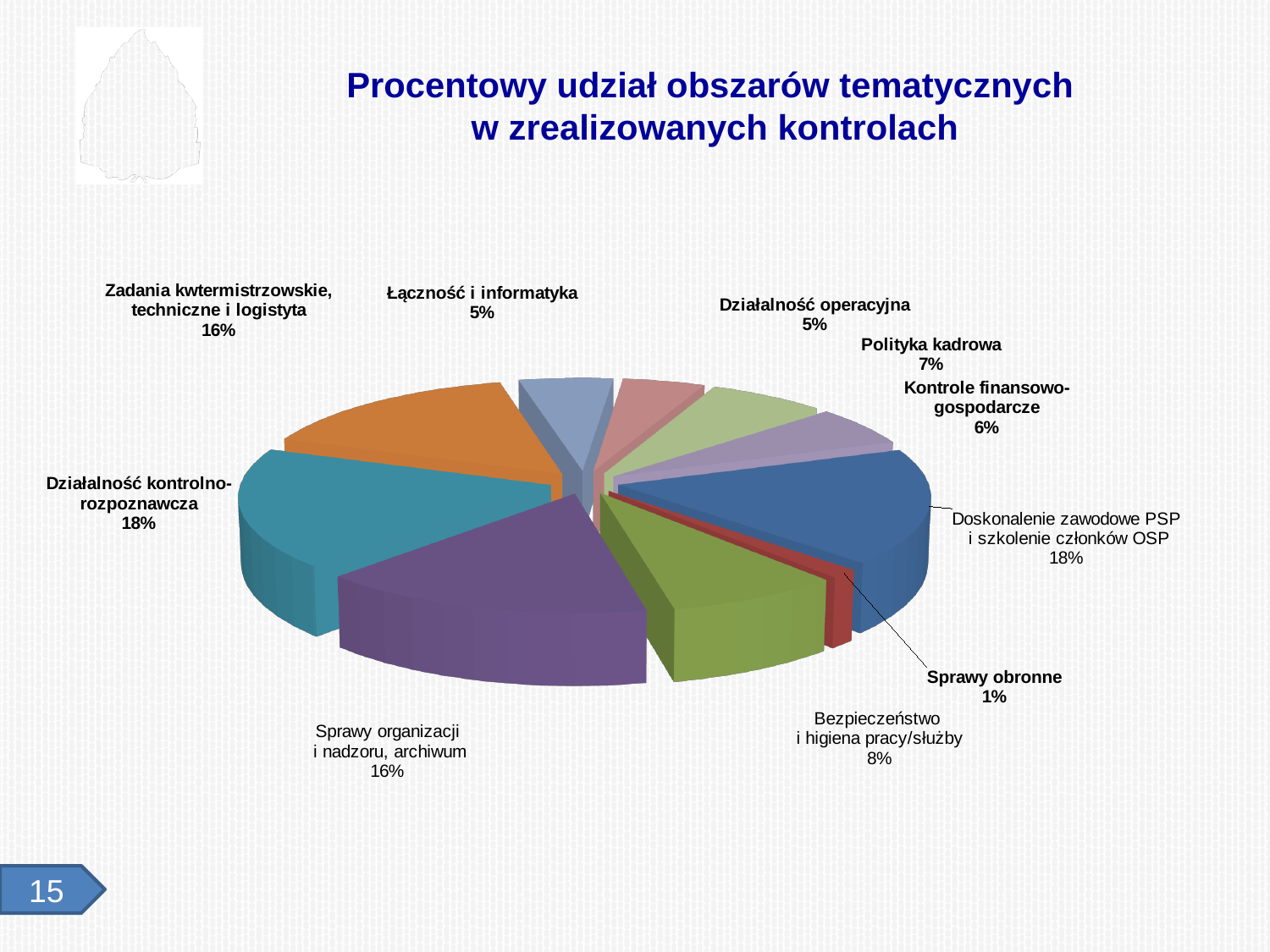
Which category has the smallest share of the pie? Sprawy obronne What percentage is shown for Polityka kadrowa? 7% What is the difference in percentage points between Doskonalenie zawodowe PSP i szkolenie członków OSP and Łączność i informatyka? 13 What type of chart is shown on the slide? pie chart Which is larger: Kontrole finansowo-gospodarcze or Zadania kwtermistrzowskie, techniczne i logistyta? Zadania kwtermistrzowskie, techniczne i logistyta What share of the pie does Kontrole finansowo-gospodarcze represent? 6% What percentage is shown for Działalność kontrolno-rozpoznawcza? 18% How many slices does the pie chart have? 10 What is the difference in percentage points between Sprawy organizacji i nadzoru, archiwum and Działalność operacyjna? 11 What is the title of the chart? Procentowy udział obszarów tematycznych w zrealizowanych kontrolach What percentage is shown for Sprawy obronne? 1% What percentage is shown for Bezpieczeństwo i higiena pracy/służby? 8%